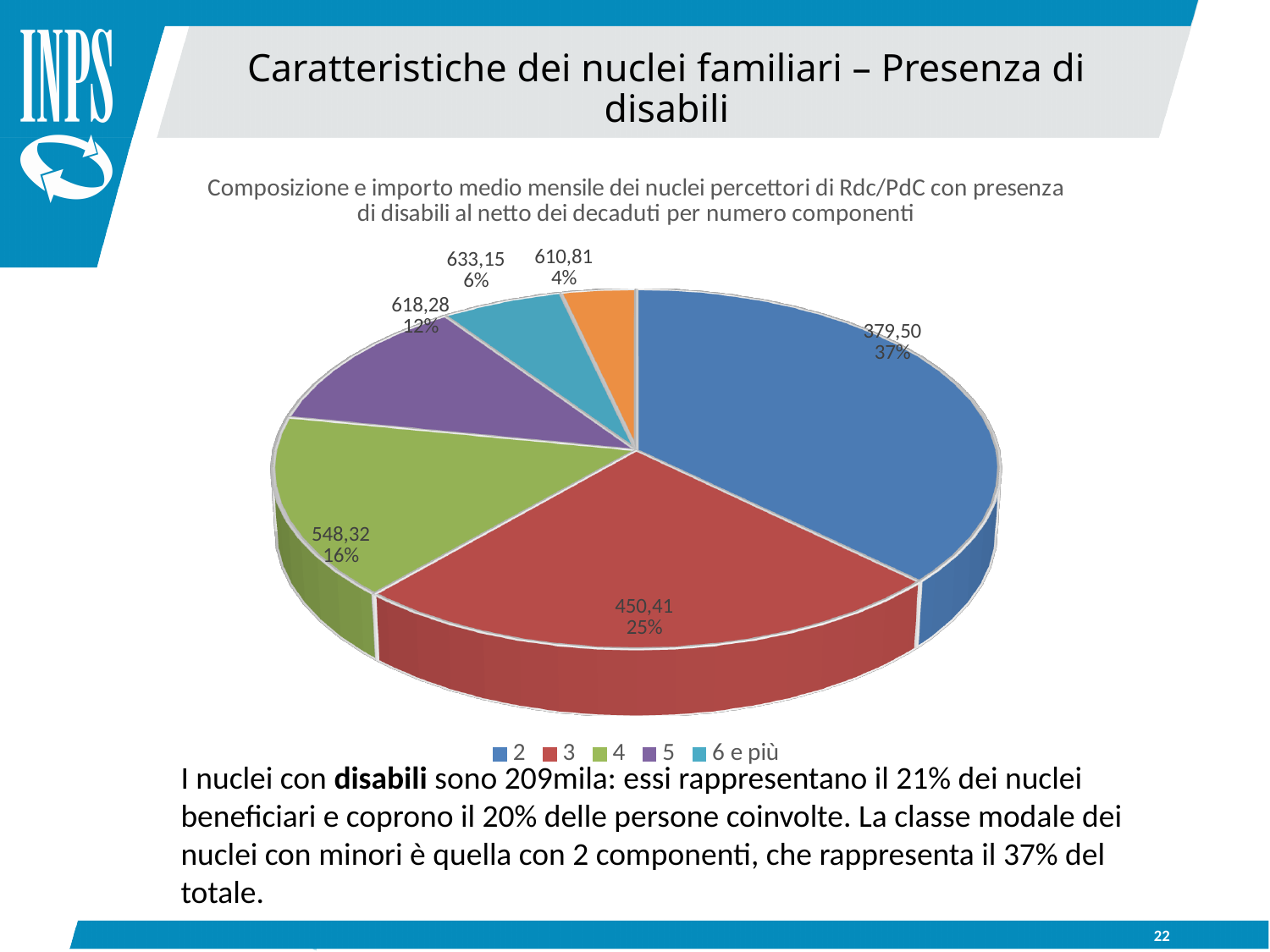
Which category has the largest share of the pie? 2 What is the average monthly amount shown for the category "5"? 618,28 Which legend category has the highest average monthly amount? 6 e più What is the difference in share between category "2" and category "3"? 12 percentage points What share of the pie does the category "4" represent? 16% What share of the pie does the category "2" represent? 37% What is the average monthly amount shown for the category "3"? 450,41 Which has the larger share of the pie, category "3" or category "4"? 3 What share of the pie does the category "6 e più" represent? 6% How many entries does the legend list? 5 What kind of chart is shown on the slide? pie chart What colour is the slice for category "2"? blue